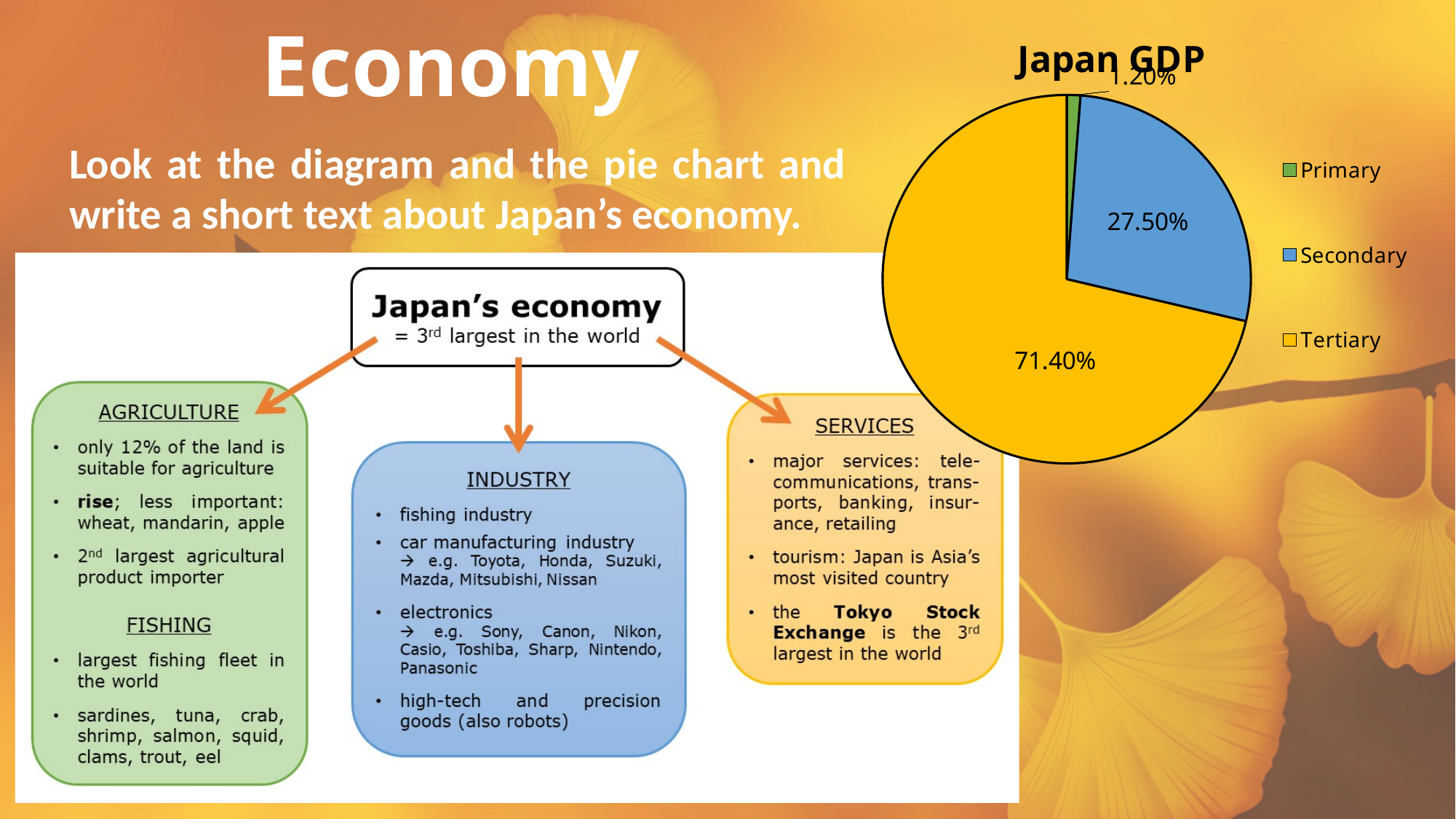
In the Japan GDP pie chart, which is larger, the Secondary or the Primary slice? Secondary How many sectors does the legend of the Japan GDP pie chart list? 3 In the Japan GDP pie chart, what is the difference between the Tertiary and Secondary shares? 43.90% What share of Japan's GDP does the Primary sector account for in the pie chart? 1.20% Which sector has the largest slice in the Japan GDP pie chart? Tertiary What kind of chart is the Japan GDP chart? pie chart What share of Japan's GDP does the Secondary sector account for in the pie chart? 27.50% Which sector has the smallest slice in the Japan GDP pie chart? Primary What colour is the Tertiary slice in the Japan GDP pie chart? yellow How many slices does the Japan GDP pie chart have? 3 What share of Japan's GDP does the Tertiary sector account for in the pie chart? 71.40% What is the title of the pie chart? Japan GDP